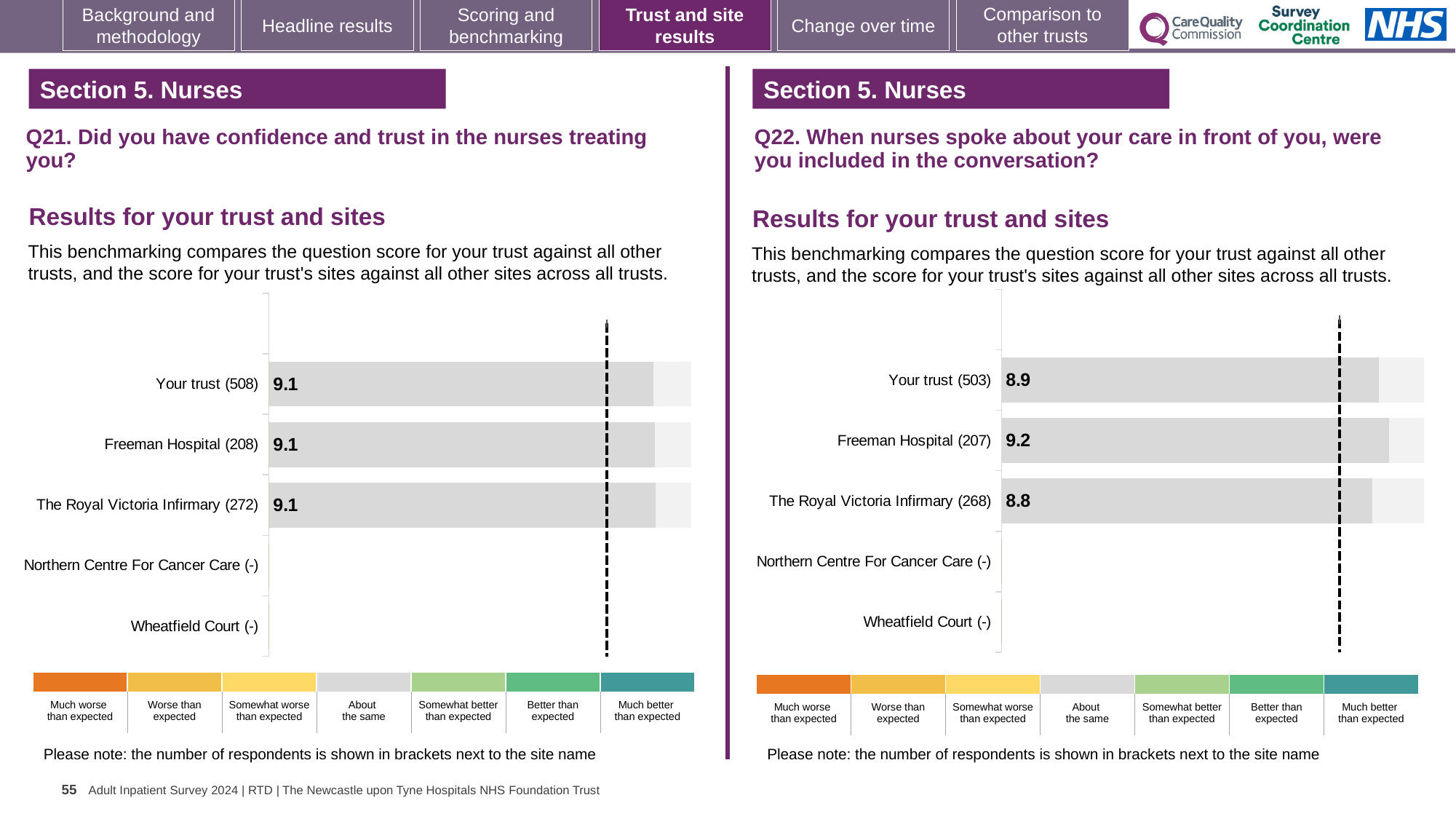
In the Q22 chart, which site has the highest score? Freeman Hospital What kind of chart is used for the Q21 results? Bar chart In the Q22 chart, what is the difference between the scores for Freeman Hospital and The Royal Victoria Infirmary? 0.4 In the Q21 chart, what is the score for Your trust? 9.1 In the Q22 chart, which of the sites with a score shown has the lowest score? The Royal Victoria Infirmary In the Q22 chart, what is the score for Freeman Hospital? 9.2 In the Q22 chart, what is the score for Your trust? 8.9 In the Q21 chart, how many respondents are shown in brackets for Freeman Hospital? 208 In the Q22 chart, what is the score for The Royal Victoria Infirmary? 8.8 How many site or trust categories are listed on the Q21 chart? 5 In the Q22 chart, which has the larger score, Your trust or Freeman Hospital? Freeman Hospital In the Q21 chart, what is the score for The Royal Victoria Infirmary? 9.1